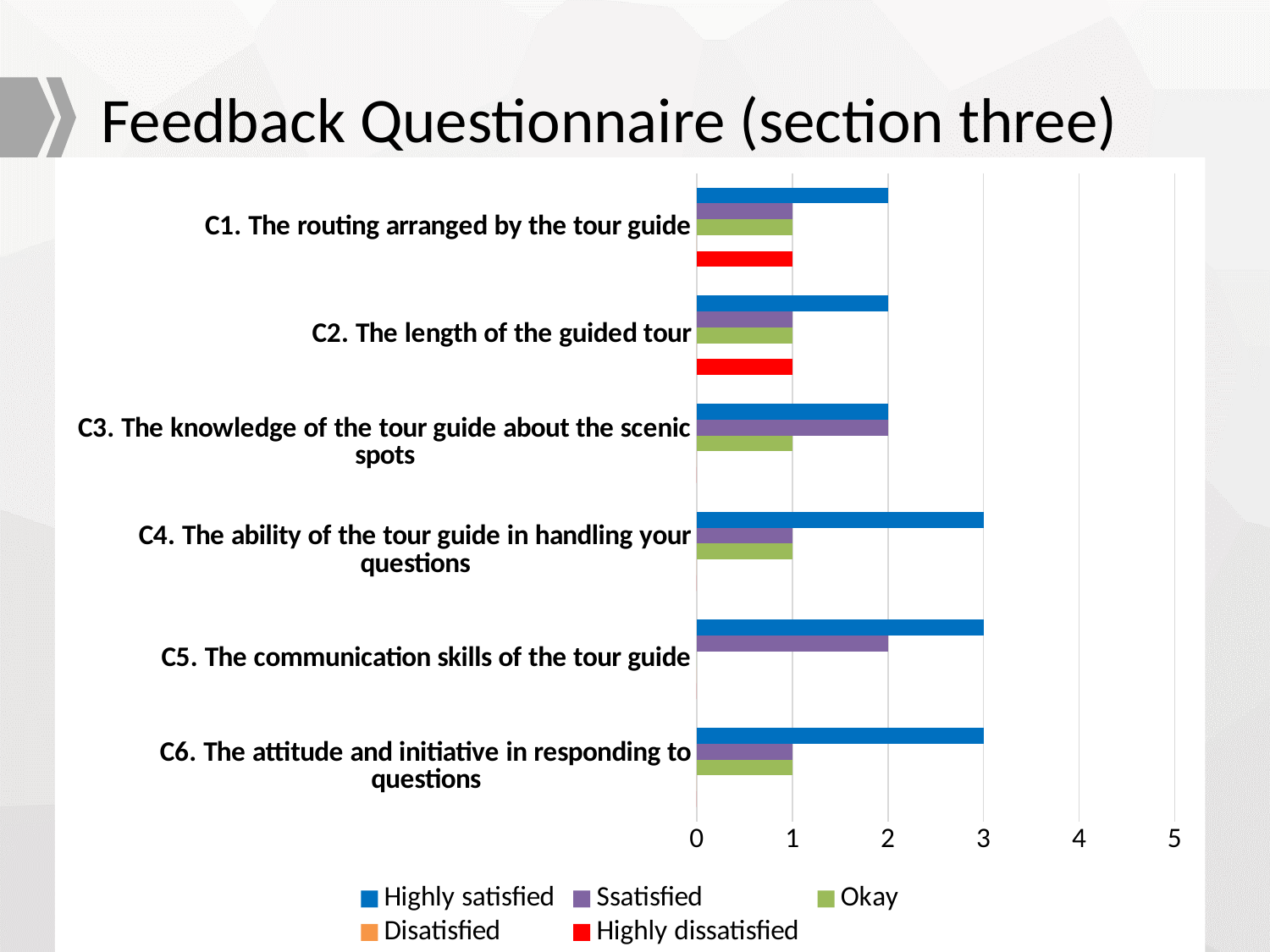
What is the total of all bars for C1. The routing arranged by the tour guide? 5 What is the Highly dissatisfied value for C2. The length of the guided tour? 1 What kind of chart is shown on the slide? bar chart What colour represents the Highly dissatisfied series in the legend? red What is the Ssatisfied value for C5. The communication skills of the tour guide? 2 What is the Highly satisfied value for C1. The routing arranged by the tour guide? 2 Which is larger for C3. The knowledge of the tour guide about the scenic spots: the Ssatisfied value or the Okay value? Ssatisfied Is the Highly satisfied value for C5. The communication skills of the tour guide greater or less than 2? greater What is the difference between the Highly satisfied value for C6 and the Highly satisfied value for C2? 1 How many categories (questionnaire items) are plotted on the chart? 6 How many series does the legend list? 5 What is the Highly satisfied value for C4. The ability of the tour guide in handling your questions? 3